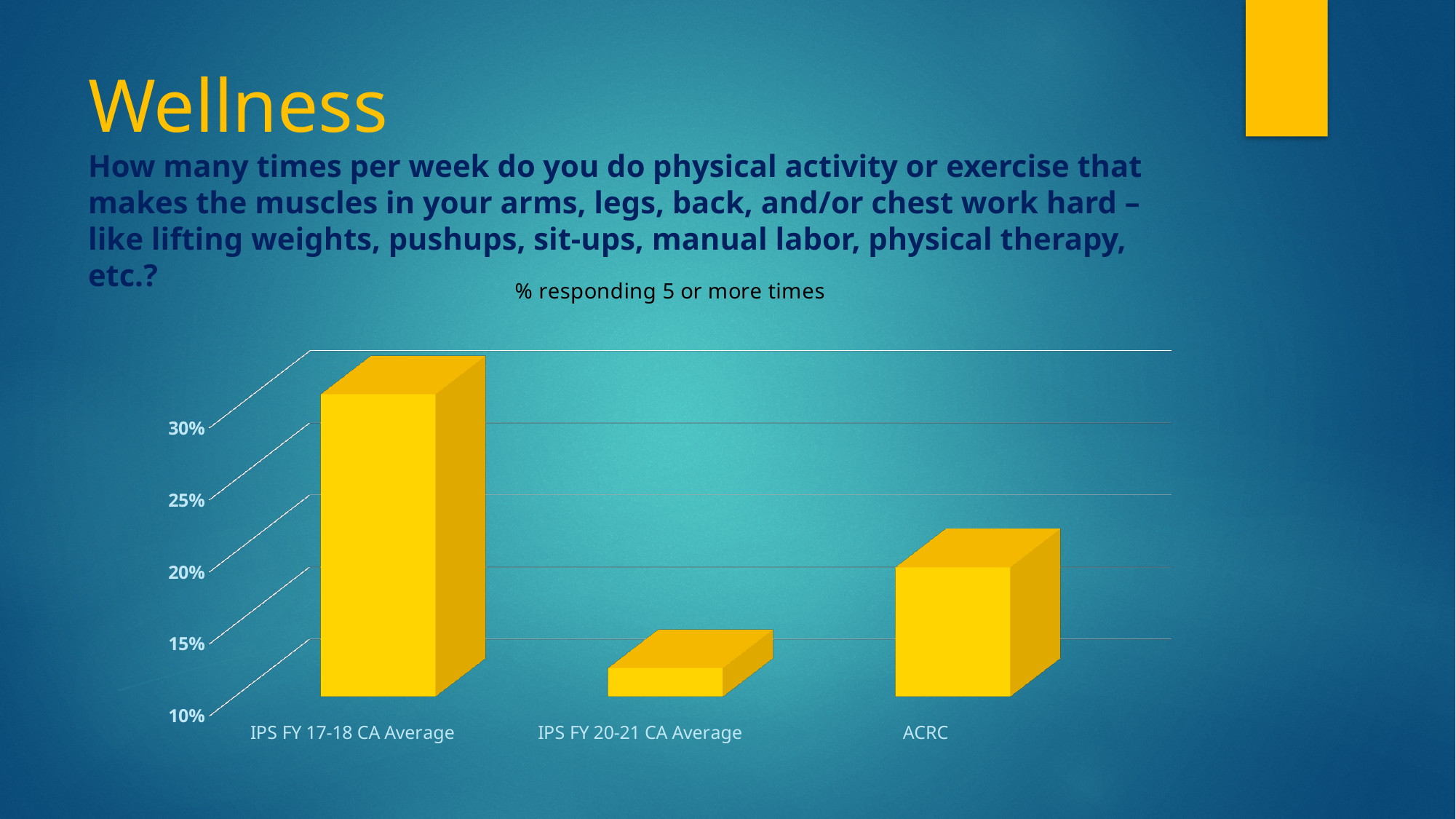
Is the value for ACRC greater or less than 15%? greater What is the title of the chart? % responding 5 or more times Which is larger, the value for ACRC or the value for IPS FY 20-21 CA Average? ACRC Is the value for IPS FY 20-21 CA Average greater or less than 15%? less How many categories are plotted in the chart? 3 Does the value rise or fall from IPS FY 17-18 CA Average to IPS FY 20-21 CA Average? fall Which category has the highest value? IPS FY 17-18 CA Average Which category has the lowest value? IPS FY 20-21 CA Average Is the value for IPS FY 17-18 CA Average greater or less than 30%? greater What colour are the bars in the chart? yellow What type of chart is shown on the slide? bar chart